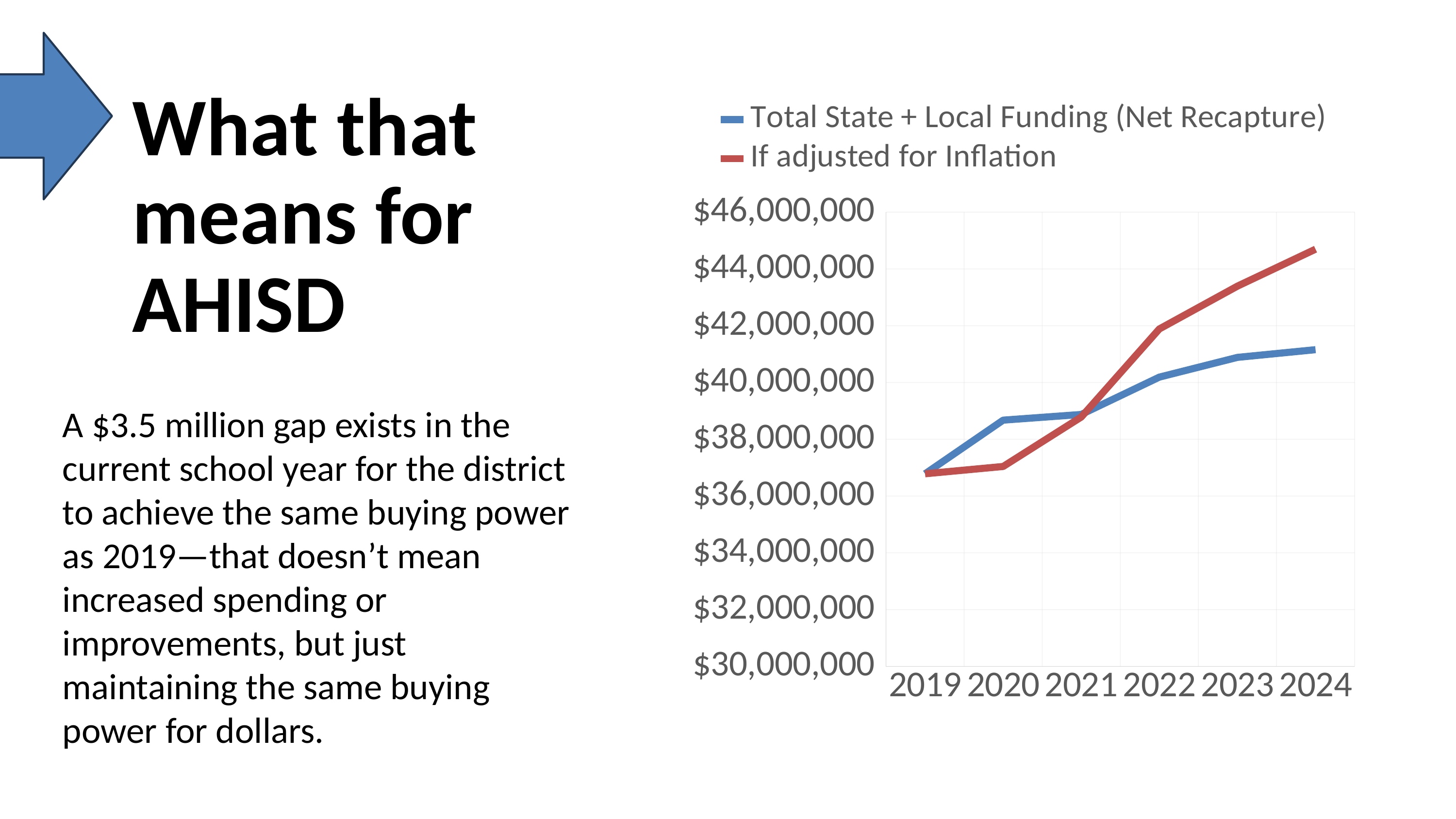
Do the values for 'If adjusted for Inflation' rise or fall from 2019 to 2024? rise Is the value for 'If adjusted for Inflation' in 2024 greater or less than $44,000,000? greater Do the values for 'Total State + Local Funding (Net Recapture)' rise or fall from 2019 to 2024? rise In 2024, which series has the higher value: 'Total State + Local Funding (Net Recapture)' or 'If adjusted for Inflation'? If adjusted for Inflation Is the value for 'If adjusted for Inflation' in 2020 greater or less than $38,000,000? less What kind of chart is shown on the slide? line chart Is the value for 'Total State + Local Funding (Net Recapture)' in 2024 greater or less than $42,000,000? less Which series is drawn in red in the chart? If adjusted for Inflation How many series does the chart legend list? 2 What is the first year shown on the x axis of the chart? 2019 In 2020, which series has the higher value: 'Total State + Local Funding (Net Recapture)' or 'If adjusted for Inflation'? Total State + Local Funding (Net Recapture) How many years are plotted along the x axis of the chart? 6